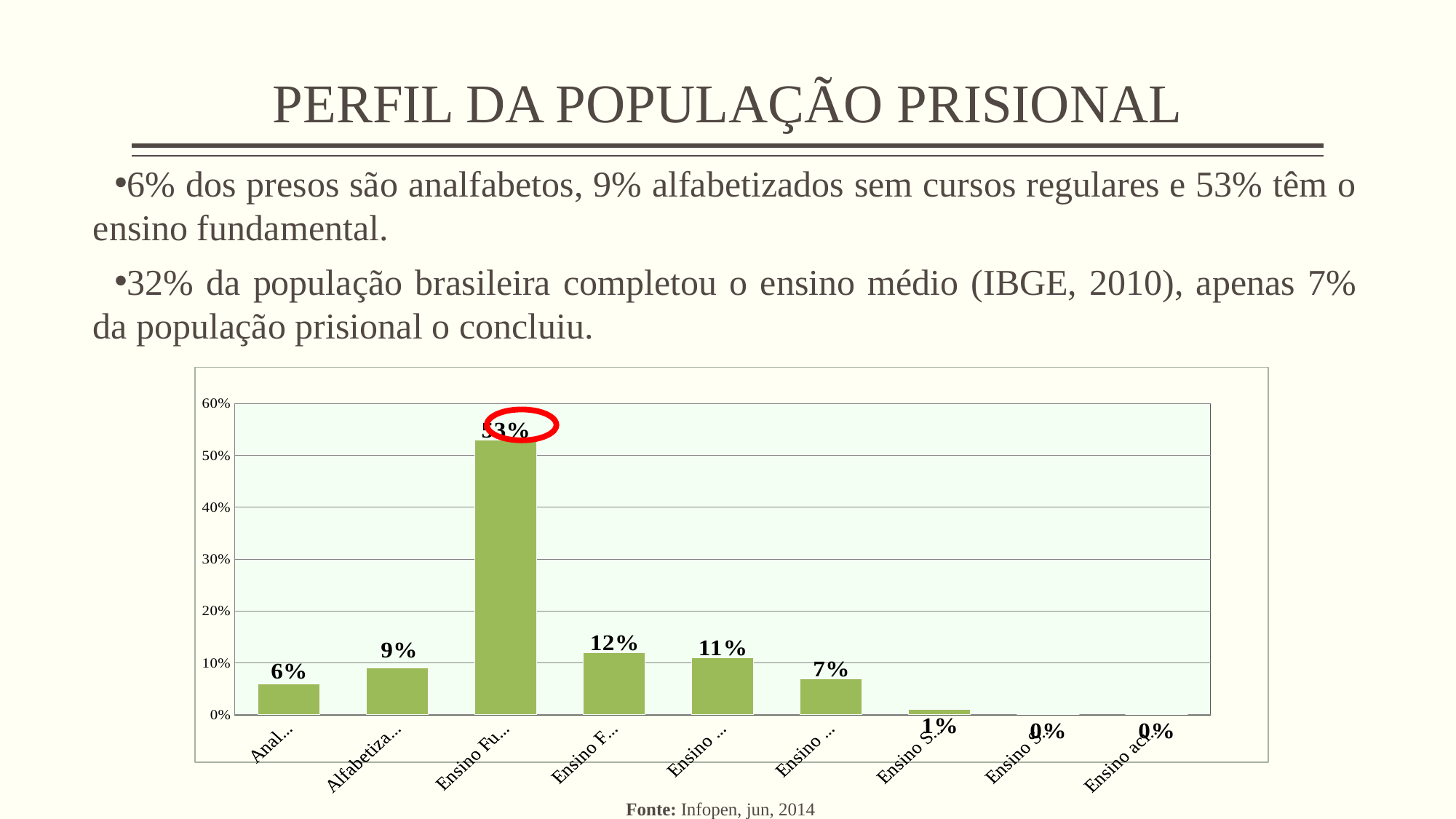
What source is cited below the chart? Infopen, jun, 2014 What is the difference between the highest bar (53%) and the first bar "Anal..." (6%)? 47 percentage points Which is larger, the value of the fourth bar or the value of the sixth bar? The fourth bar (12%) What is the value shown for the fourth bar from the left? 12% How many bars (categories) does the chart show? 9 What kind of chart is shown on the slide? Bar chart What is the value shown for the first bar, labelled "Anal..."? 6% What is the value shown for the sixth bar from the left? 7% What is the value shown for the bar labelled "Alfabetiza..."? 9% How many bars in the chart are labelled 0%? 2 Is the value of the tallest bar greater or less than 50%? greater Which category has the highest value in the chart? Ensino Fu... (the third bar), 53%